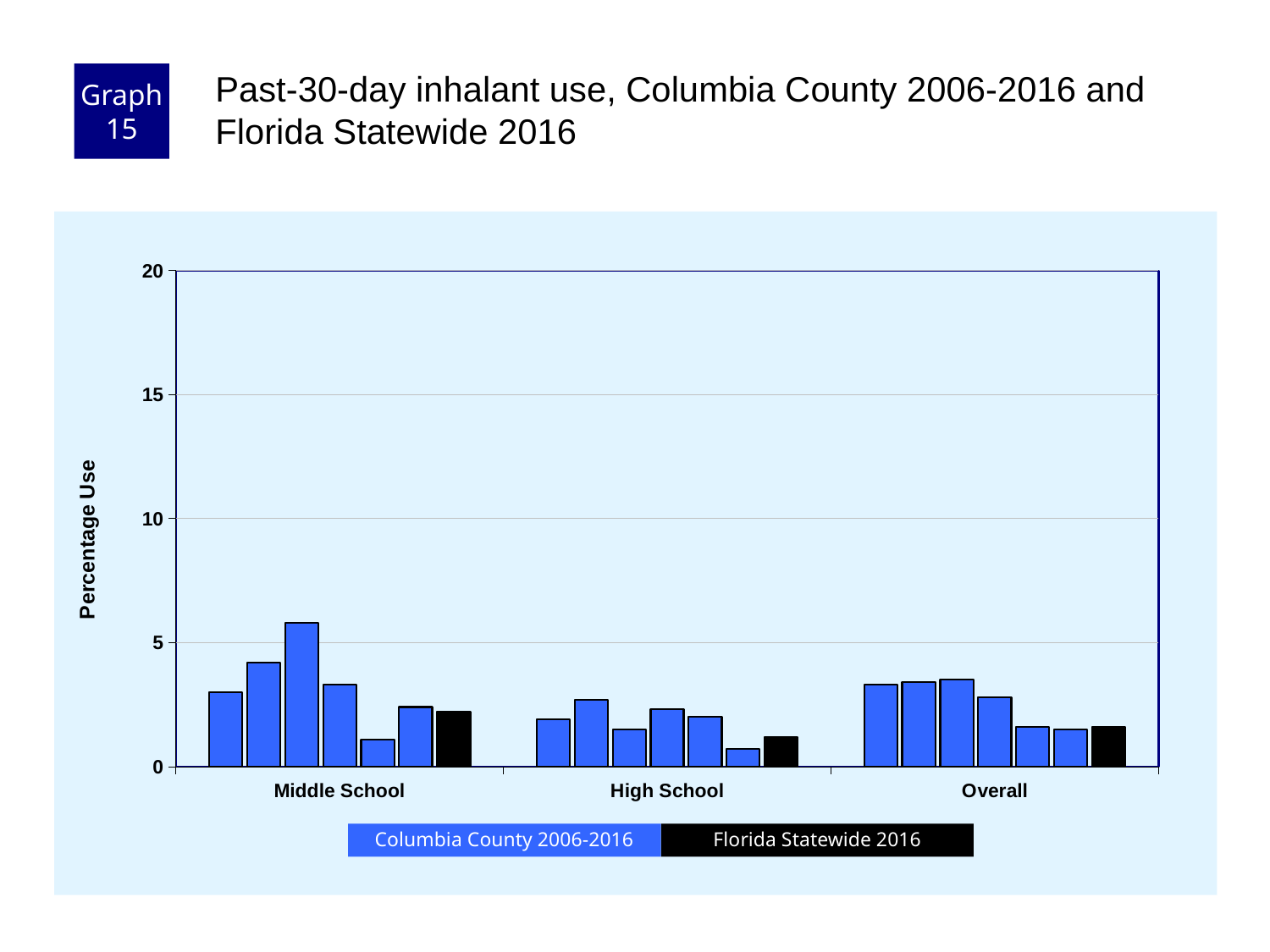
Which category has the lowest Florida Statewide 2016 value? High School Is the Florida Statewide 2016 value for Overall greater or less than 10? less Are all the bars in the High School group below 5? yes What kind of chart is shown on the slide? bar chart What is the label on the vertical axis of the chart? Percentage Use Which is larger, the Florida Statewide 2016 value for Middle School or for High School? Middle School Which category group contains the tallest bar in the chart? Middle School Is the tallest bar in the Middle School group greater or less than 5? greater What is the highest value shown on the vertical axis of the chart? 20 How many series does the chart's legend list? 2 How many categories are shown on the x axis of the chart? 3